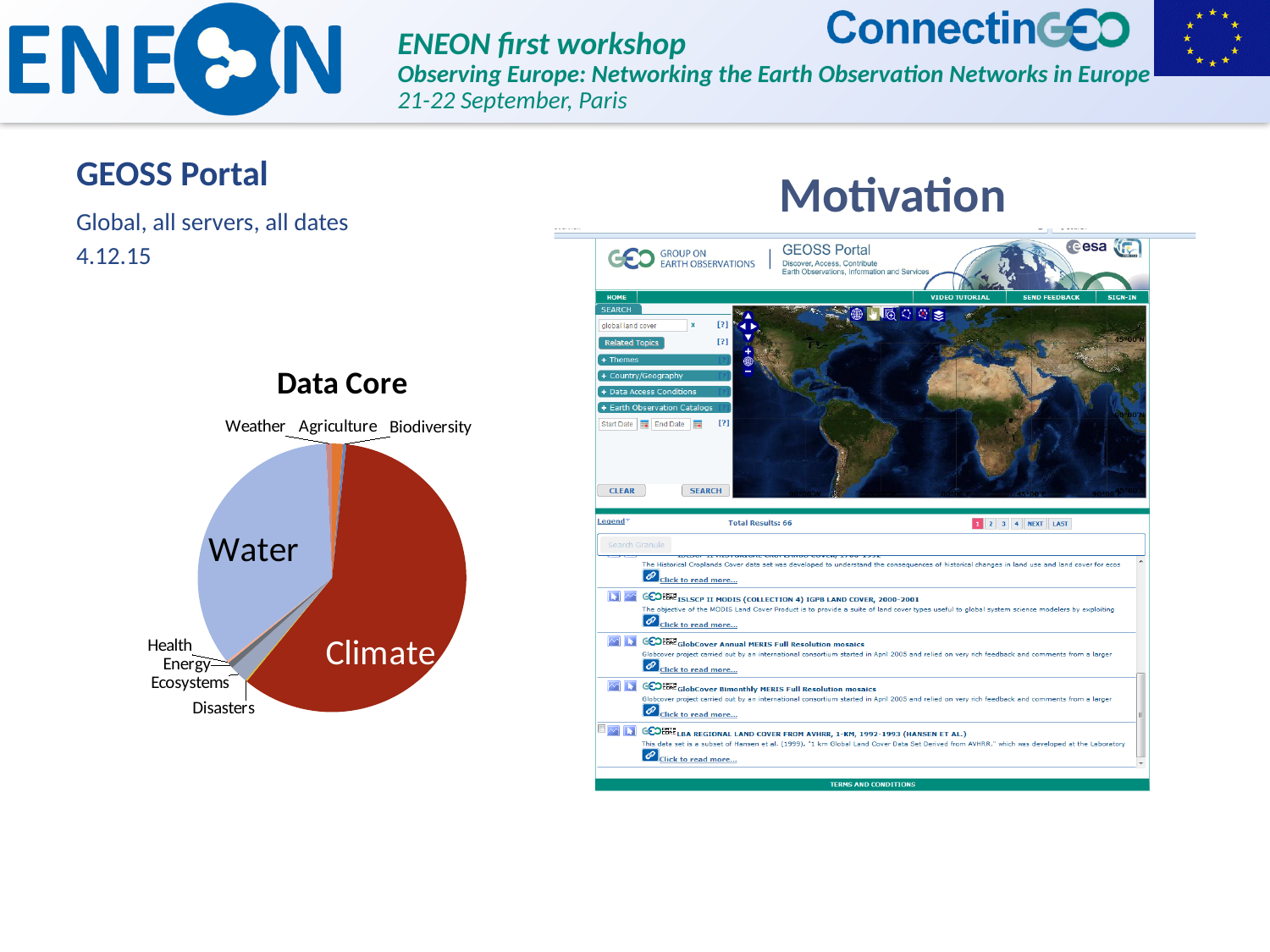
Which two categories together make up most of the "Data Core" pie chart? Climate and Water In the "Data Core" pie chart, which slice is larger, Water or Disasters? Water In the "Data Core" pie chart, which slice is larger, Climate or Water? Climate What is the title of the pie chart on the slide? Data Core In the "Data Core" pie chart, which slice is larger, Climate or Health? Climate What kind of chart is the "Data Core" chart? pie chart How many categories are shown in the "Data Core" pie chart? 9 Which category has the largest slice in the "Data Core" pie chart? Climate